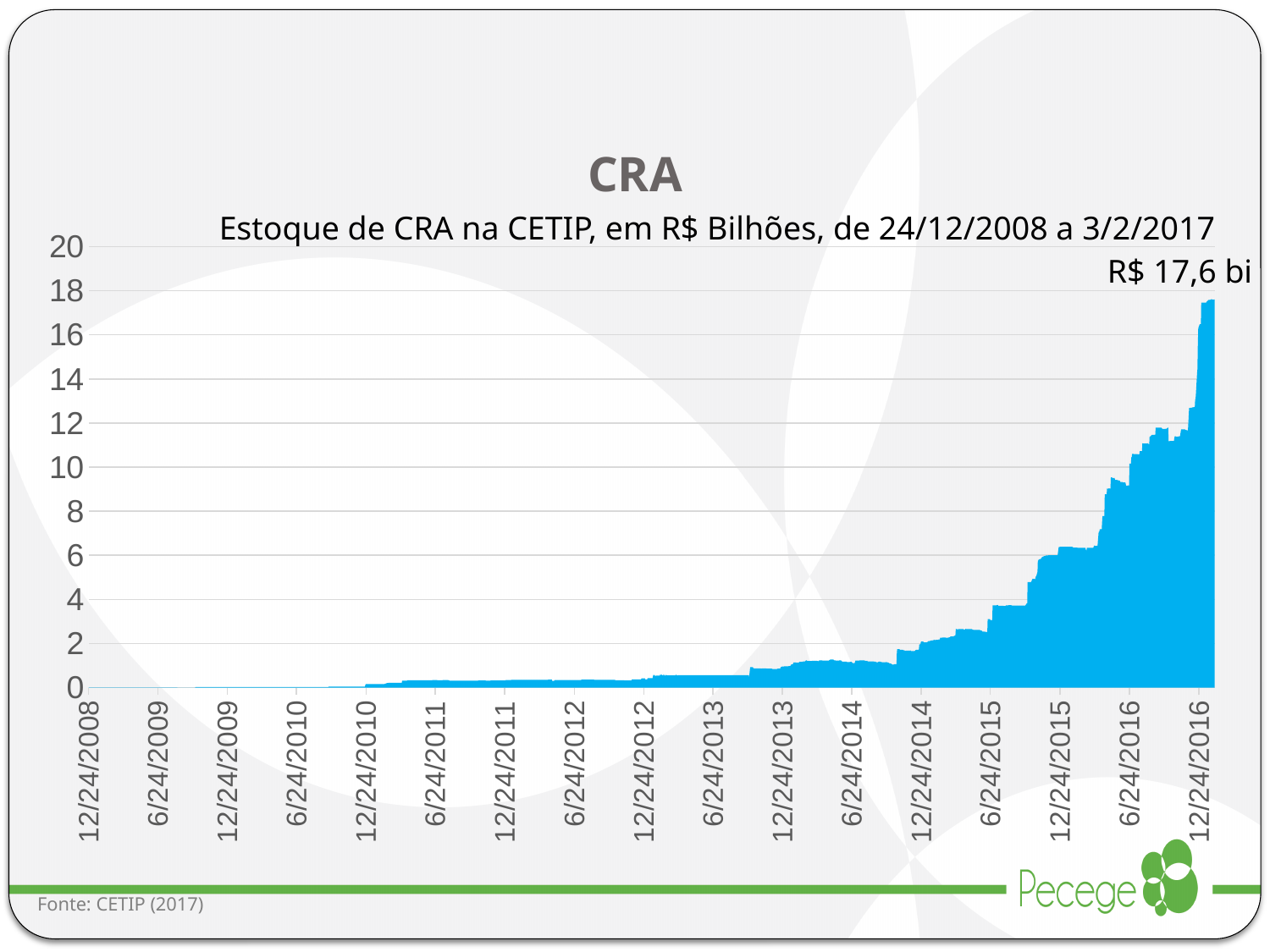
What kind of chart is shown on the slide? area chart Is the value at 12/24/2013 greater or less than 2? less How many date labels are shown on the x axis? 17 What is the final value of the CRA stock shown at the end of the series? R$ 17,6 bi Which is larger, the value at 6/24/2015 or the value at 6/24/2016? 6/24/2016 Is the value at 12/24/2016 greater or less than 10? greater Is the value at 12/24/2015 greater or less than 4? greater Do the values generally rise or fall from 12/24/2008 to the end of the series? rise What is the title of the chart? CRA What is the source cited for the chart? CETIP (2017)